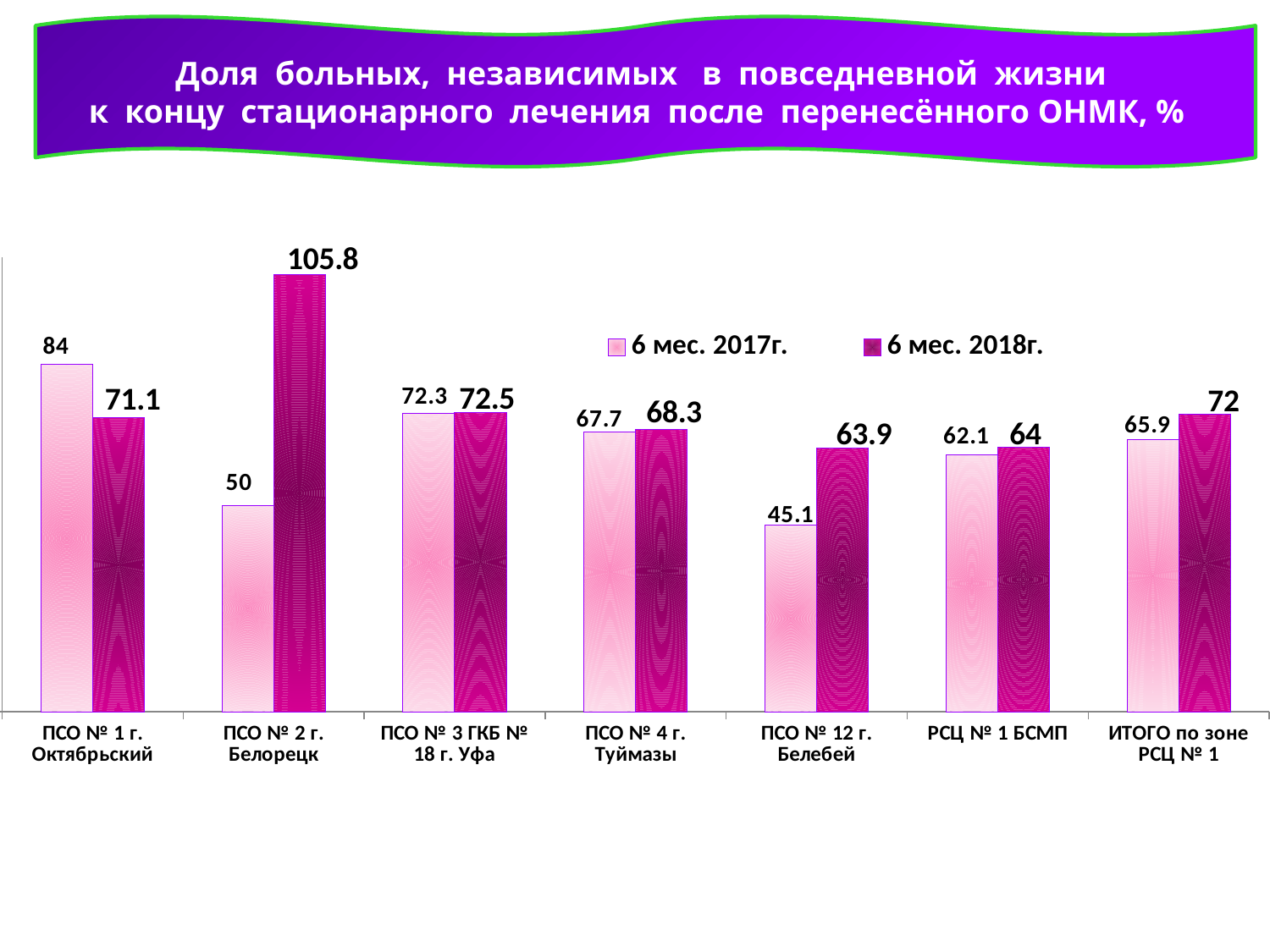
How many series does the legend list? 2 What is the value for ИТОГО по зоне РСЦ № 1 in the 6 мес. 2018г. series? 72 What is the value for ПСО № 12 г. Белебей in the 6 мес. 2017г. series? 45.1 What are the two series named in the legend? 6 мес. 2017г. and 6 мес. 2018г. Which category has the lowest value in the 6 мес. 2018г. series? ПСО № 12 г. Белебей What is the difference between the 6 мес. 2018г. and 6 мес. 2017г. values for ПСО № 12 г. Белебей? 18.8 What is the value for ПСО № 2 г. Белорецк in the 6 мес. 2018г. series? 105.8 Which category has the highest value in the 6 мес. 2017г. series? ПСО № 1 г. Октябрьский Which is larger for ПСО № 1 г. Октябрьский: the 6 мес. 2017г. value or the 6 мес. 2018г. value? 6 мес. 2017г. What is the difference between the 6 мес. 2018г. and 6 мес. 2017г. values for ПСО № 2 г. Белорецк? 55.8 What kind of chart is shown on the slide? Bar chart How many categories are shown on the x axis? 7